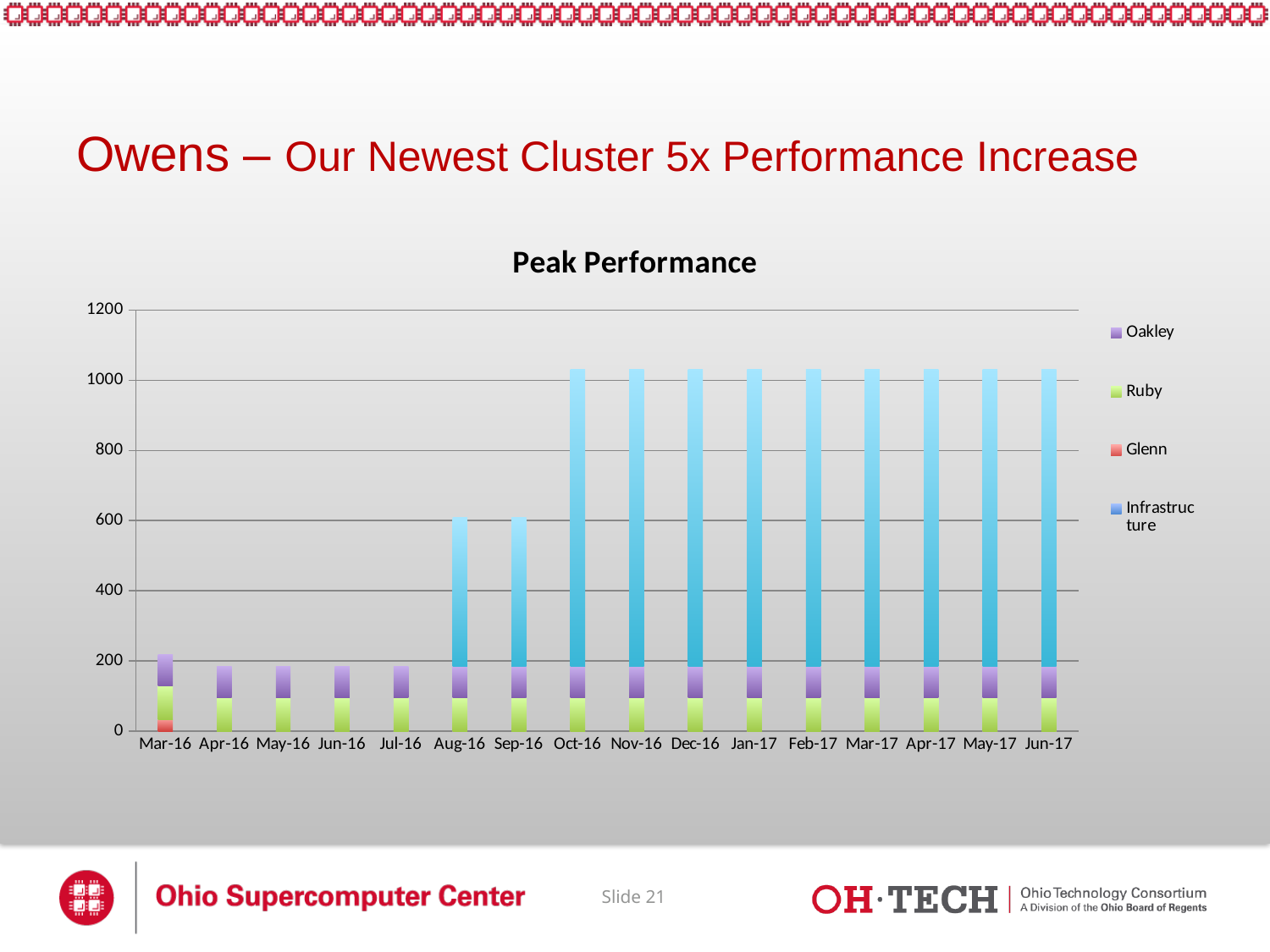
Do the total values generally rise or fall from Mar-16 to Jun-17? Rise Is the total value for Oct-16 greater or less than 800? greater Is the total value for Aug-16 greater or less than 400? greater How many months are shown along the x axis? 16 Is the total value for Jun-17 greater or less than 1200? less What is the title of the chart? Peak Performance Which month has the larger total, Aug-16 or Oct-16? Oct-16 How many series does the legend list? 4 What type of chart is shown on the slide? Stacked bar chart Which is the only month in which the Glenn series appears? Mar-16